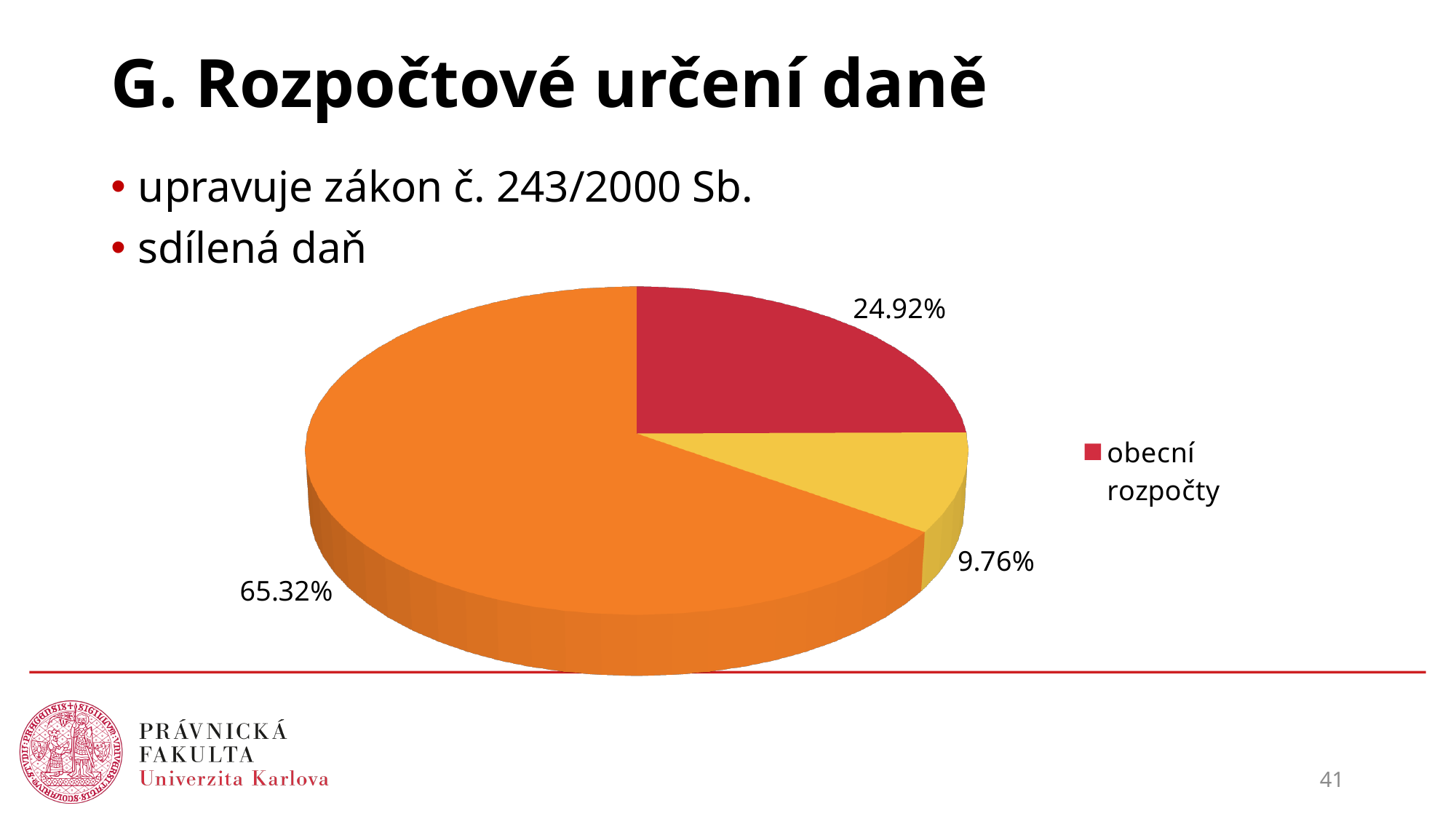
What kind of chart is shown on the slide? pie chart What is the difference between the 'obecní rozpočty' slice and the yellow slice? 15.16% Which is larger: the 'obecní rozpočty' slice or the yellow slice? obecní rozpočty What is the difference between the orange slice (65.32%) and the 'obecní rozpočty' slice (24.92%)? 40.40% What value is labelled on the yellow slice of the pie chart? 9.76% Which legend entry is shown next to the pie chart? obecní rozpočty How many slices does the pie chart have? 3 What colour is the 'obecní rozpočty' slice in the pie chart? red Which slice of the pie chart is the smallest? the yellow slice (9.76%) What value is labelled on the orange slice of the pie chart? 65.32% Which slice of the pie chart is the largest? the orange slice (65.32%) What share of the pie does the 'obecní rozpočty' slice represent? 24.92%